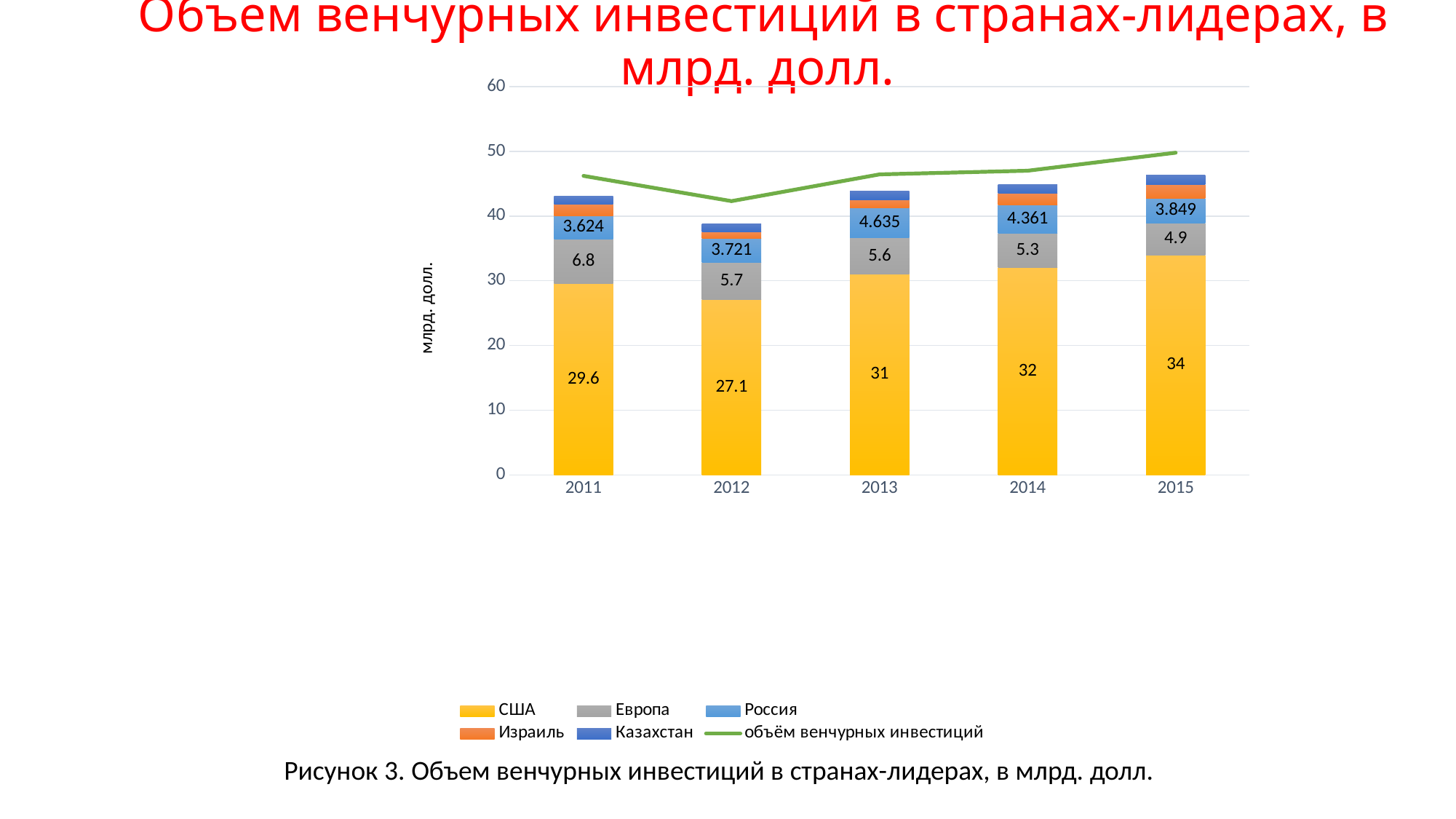
In which year is the value for Россия the lowest? 2011 What is the value for Европа in 2011? 6.8 How many series does the legend list? 6 In which year is the value for Европа the highest? 2011 Is the value of the line 'объём венчурных инвестиций' in 2012 greater or less than 50? less Which is larger: the Россия value in 2014 or in 2015? 2014 Do the values for Европа rise or fall from 2011 to 2015? fall In which year is the value for США the lowest? 2012 What is the value for Россия in 2013? 4.635 What is the difference between the США values for 2015 and 2011? 4.4 How many years are shown on the x axis? 5 What is the value for США in 2015? 34